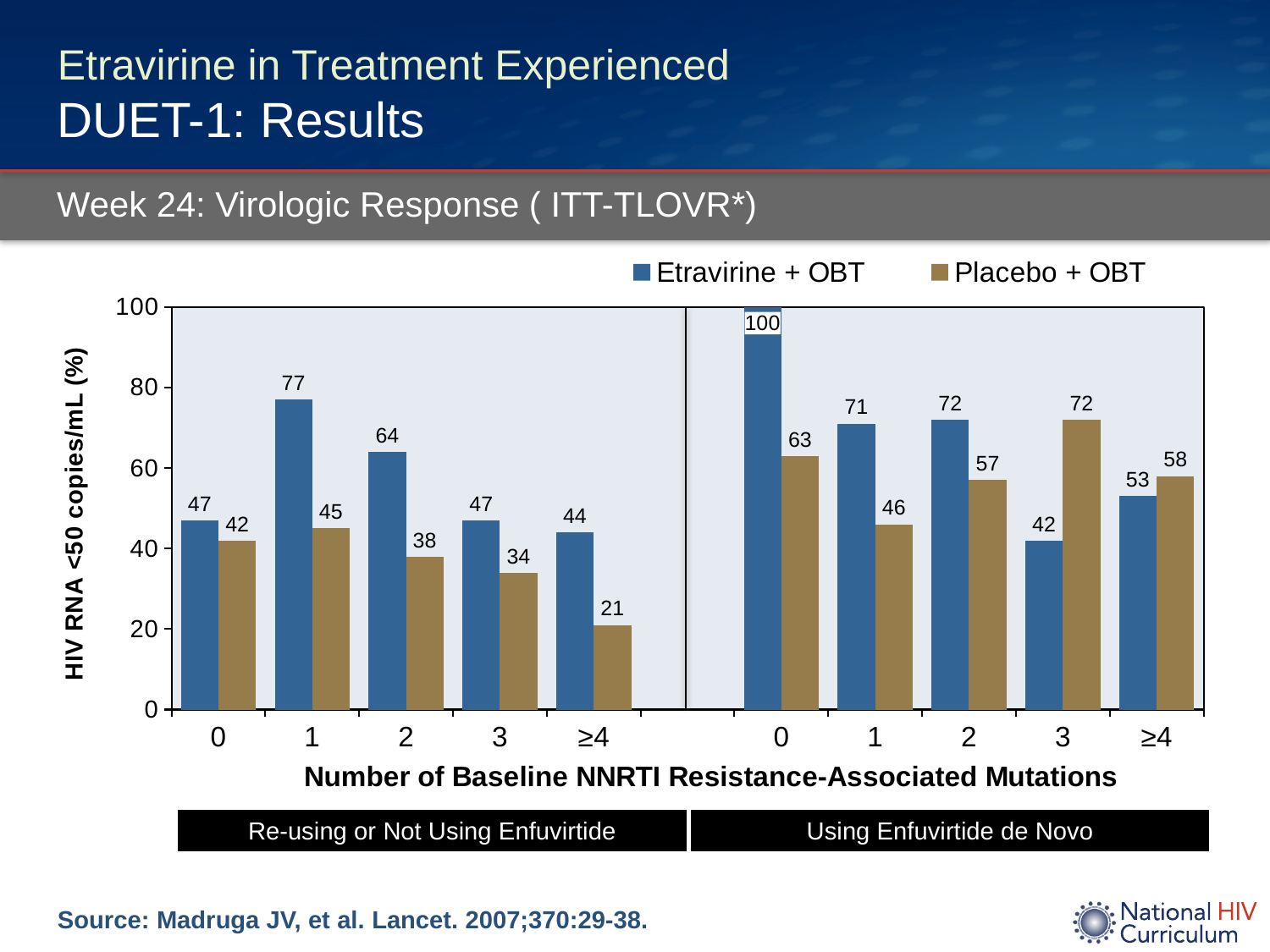
In the 'Re-using or Not Using Enfuvirtide' panel, what is the difference between Etravirine + OBT and Placebo + OBT at 2 mutations? 26 What kind of chart is shown on the slide? Bar chart How many mutation categories are shown on the x axis in the 'Using Enfuvirtide de Novo' panel? 5 In the 'Re-using or Not Using Enfuvirtide' panel, which mutation category has the highest Etravirine + OBT value? 1 In the 'Using Enfuvirtide de Novo' panel, what is the difference between Etravirine + OBT and Placebo + OBT at 0 mutations? 37 In the 'Using Enfuvirtide de Novo' panel at 3 mutations, which is larger: Etravirine + OBT or Placebo + OBT? Placebo + OBT How many series does the legend list? 2 In the 'Using Enfuvirtide de Novo' panel, what is the value for Placebo + OBT at 3 baseline NNRTI resistance-associated mutations? 72 In the 'Re-using or Not Using Enfuvirtide' panel, what is the value for Etravirine + OBT at 1 baseline NNRTI resistance-associated mutation? 77 In the 'Re-using or Not Using Enfuvirtide' panel at ≥4 mutations, which is larger: Etravirine + OBT or Placebo + OBT? Etravirine + OBT In the 'Re-using or Not Using Enfuvirtide' panel, which mutation category has the lowest Placebo + OBT value? ≥4 In the 'Using Enfuvirtide de Novo' panel, what is the value for Etravirine + OBT at 0 baseline mutations? 100